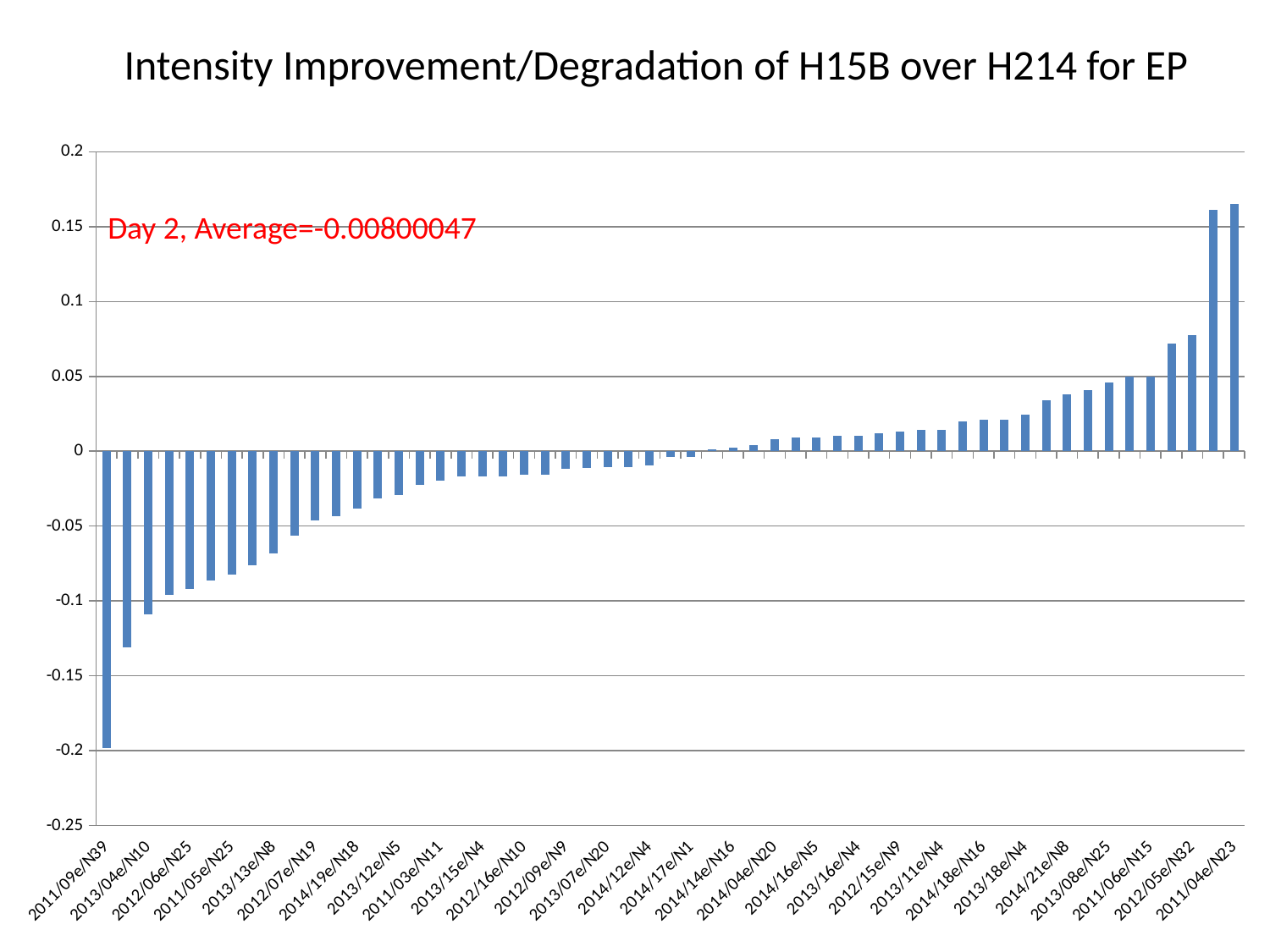
Which has the higher value, 2012/05e/N32 or 2011/04e/N23? 2011/04e/N23 Which category has the lowest value in the chart? 2011/09e/N39 Which has the higher value, 2011/09e/N39 or 2013/04e/N10? 2013/04e/N10 Do the bar values rise or fall from left to right along the x axis? rise What average value is stated in the red annotation on the chart? -0.00800047 Is the value for 2011/09e/N39 greater or less than -0.15? less Is the value for 2012/05e/N32 greater or less than 0.05? greater What is the title of the chart? Intensity Improvement/Degradation of H15B over H214 for EP Is the value for 2013/04e/N10 greater or less than -0.1? less What kind of chart is shown on the slide? bar chart